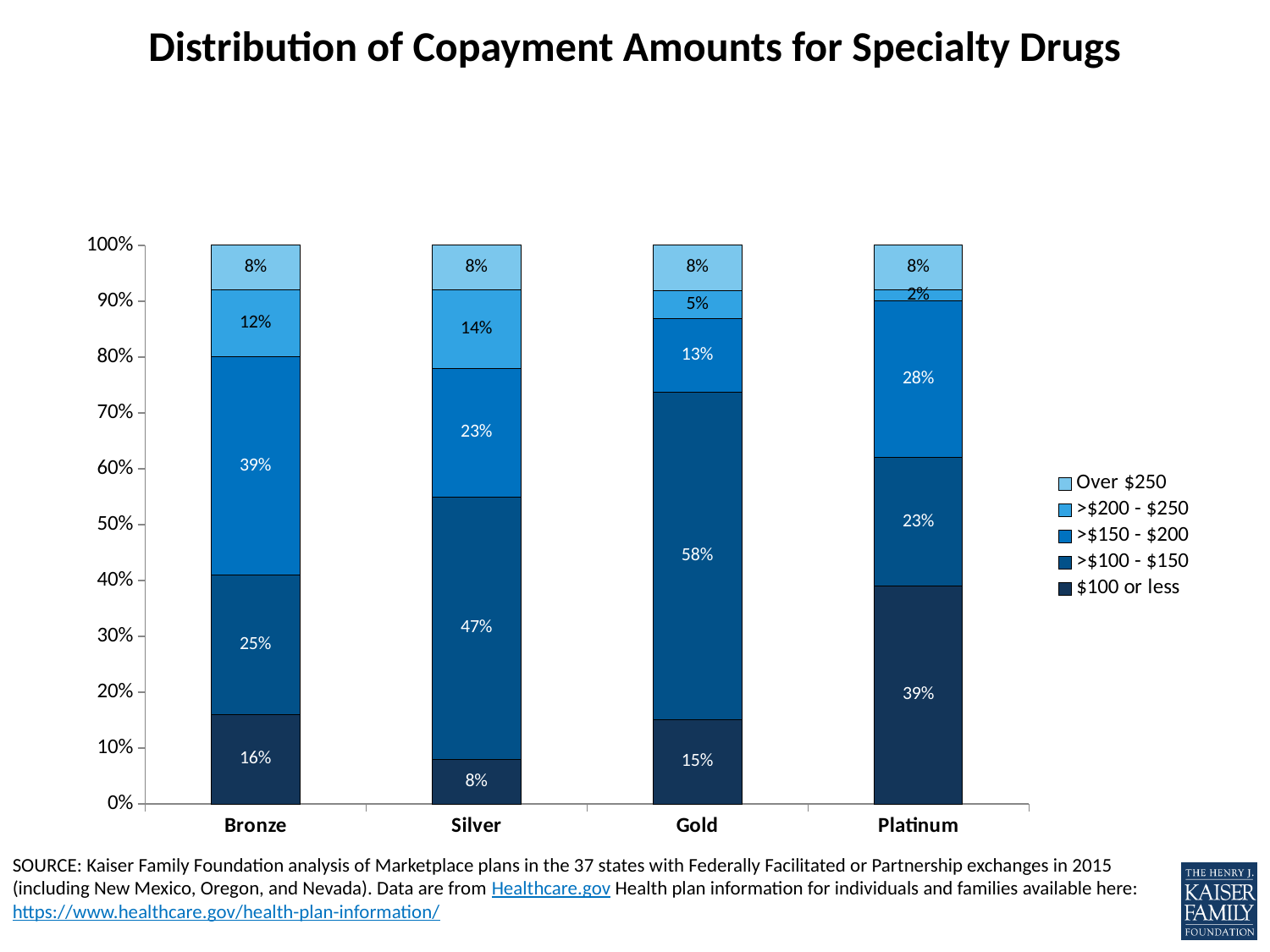
What kind of chart is shown on the slide? Stacked bar chart How many percentage points higher is the >$150 - $200 share for Bronze than for Silver? 16 percentage points How many plan types are shown on the x axis? 4 Which has a larger >$100 - $150 share, Bronze or Platinum? Bronze Which plan type has the lowest share of plans with a copayment of $100 or less? Silver What percentage of Silver plans have a specialty drug copayment of $100 or less? 8% How many copayment ranges does the legend list? 5 What is the title of the chart? Distribution of Copayment Amounts for Specialty Drugs What percentage of Platinum plans fall in the >$150 - $200 copayment range? 28% What percentage of Platinum plans fall in the >$200 - $250 copayment range? 2% What percentage of Gold plans fall in the >$100 - $150 copayment range? 58% Which plan type has the highest share of plans with a copayment of $100 or less? Platinum